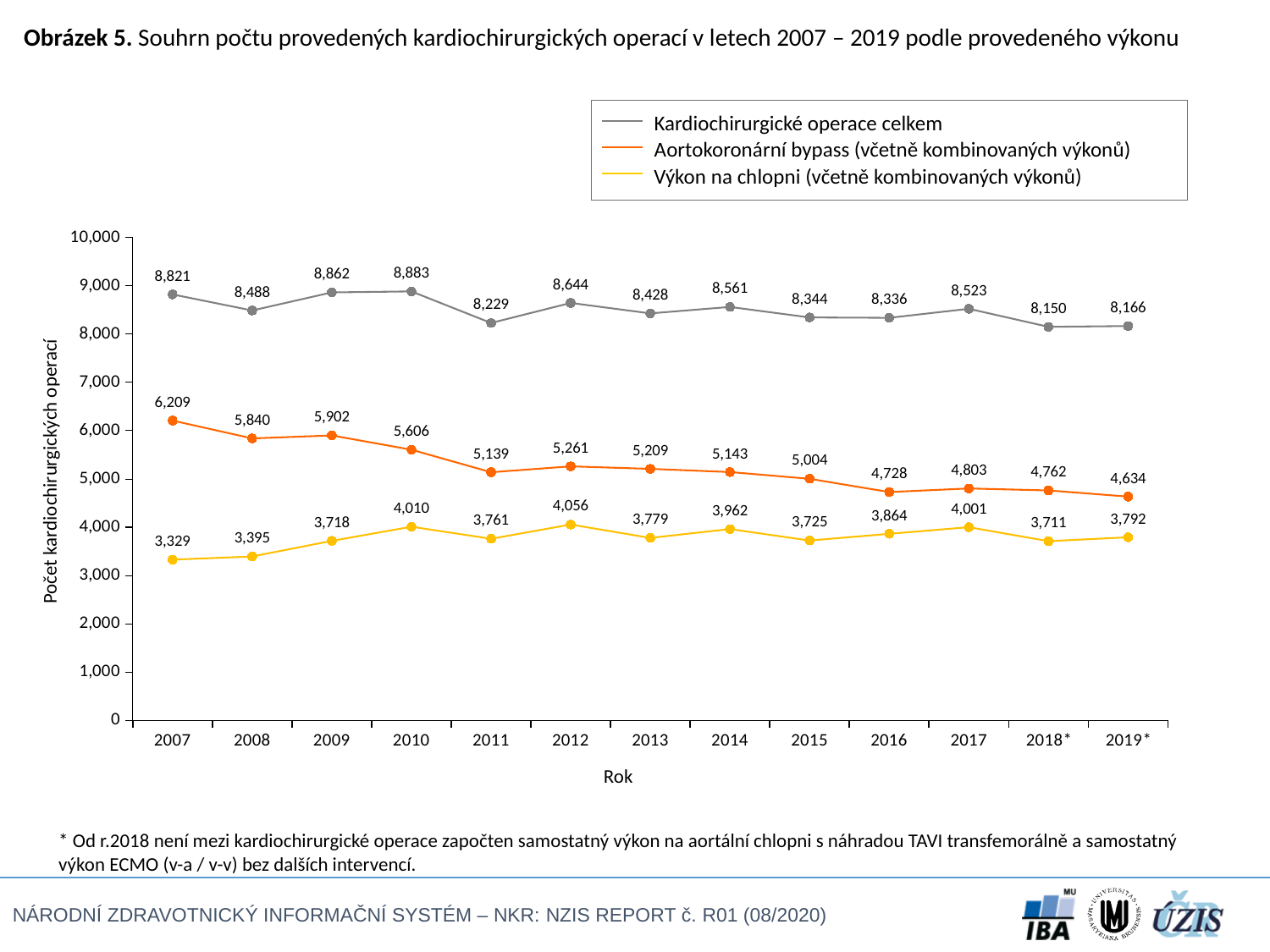
What is the value of Kardiochirurgické operace celkem in 2010? 8,883 In which year is Výkon na chlopni (včetně kombinovaných výkonů) highest? 2012 What is the difference between the Aortokoronární bypass values in 2007 and 2019*? 1,575 What is the label of the y axis? Počet kardiochirurgických operací What is the value of Výkon na chlopni (včetně kombinovaných výkonů) in 2017? 4,001 What is the value of Aortokoronární bypass (včetně kombinovaných výkonů) in 2011? 5,139 What kind of chart is shown on the slide? Line chart How many years are plotted on the x axis? 13 Does the Aortokoronární bypass series generally rise or fall from 2007 to 2019*? Fall In which year is Kardiochirurgické operace celkem lowest? 2018* Which is larger: Výkon na chlopni in 2010 or in 2013? 2010 How many series does the legend list? 3